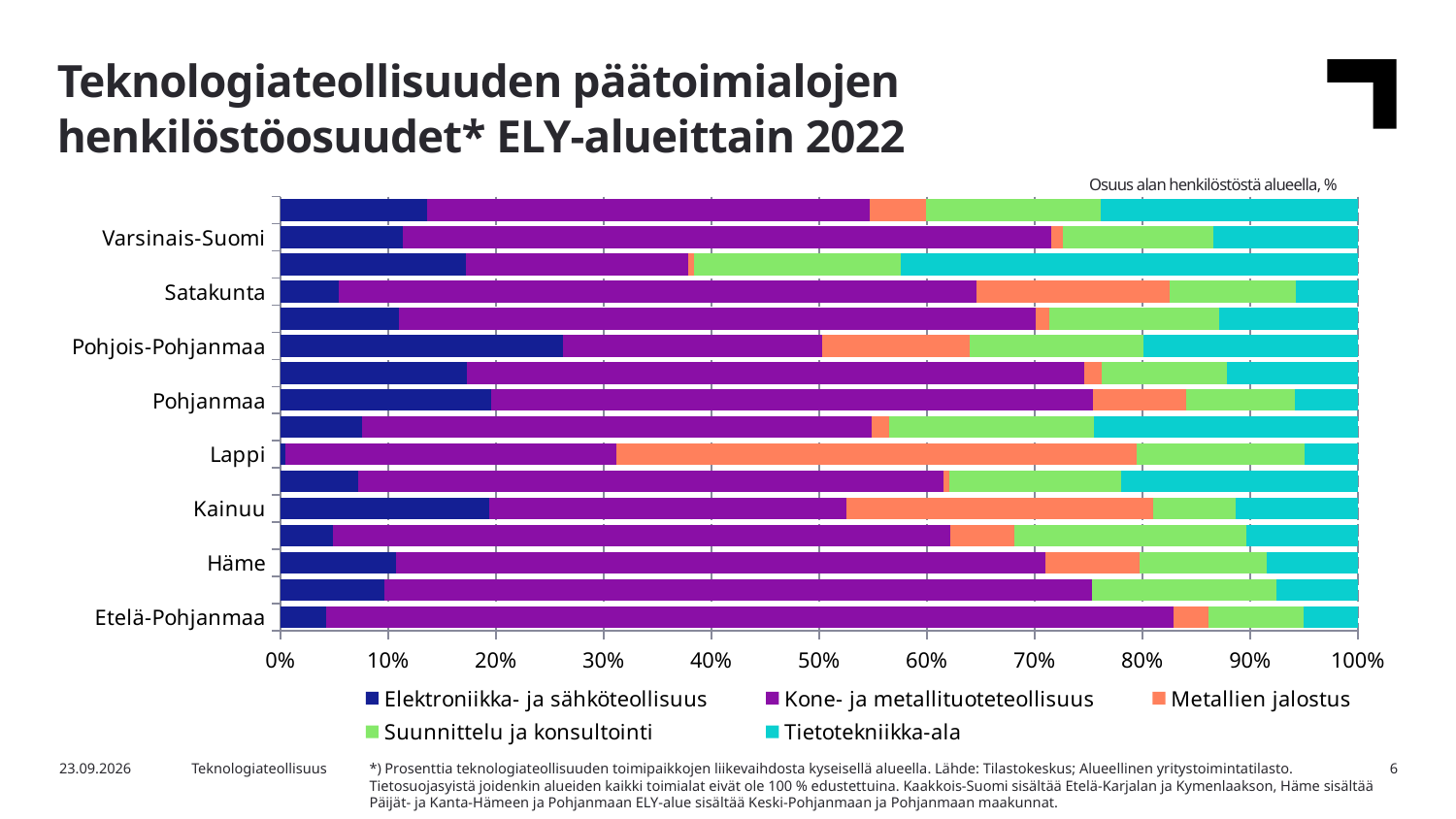
How many series does the legend list? 5 Is the value for Tietotekniikka-ala in Varsinais-Suomi greater or less than 20%? less What unit note is shown above the chart? Osuus alan henkilöstöstä alueella, % Is the value for Metallien jalostus in Lappi greater or less than 40%? greater Which region has the largest share for Metallien jalostus? Lappi Is the value for Kone- ja metallituoteteollisuus in Etelä-Pohjanmaa greater or less than 70%? greater What kind of chart is shown on the slide? Stacked bar chart Which is larger: the Elektroniikka- ja sähköteollisuus share in Pohjois-Pohjanmaa or in Etelä-Pohjanmaa? Pohjois-Pohjanmaa